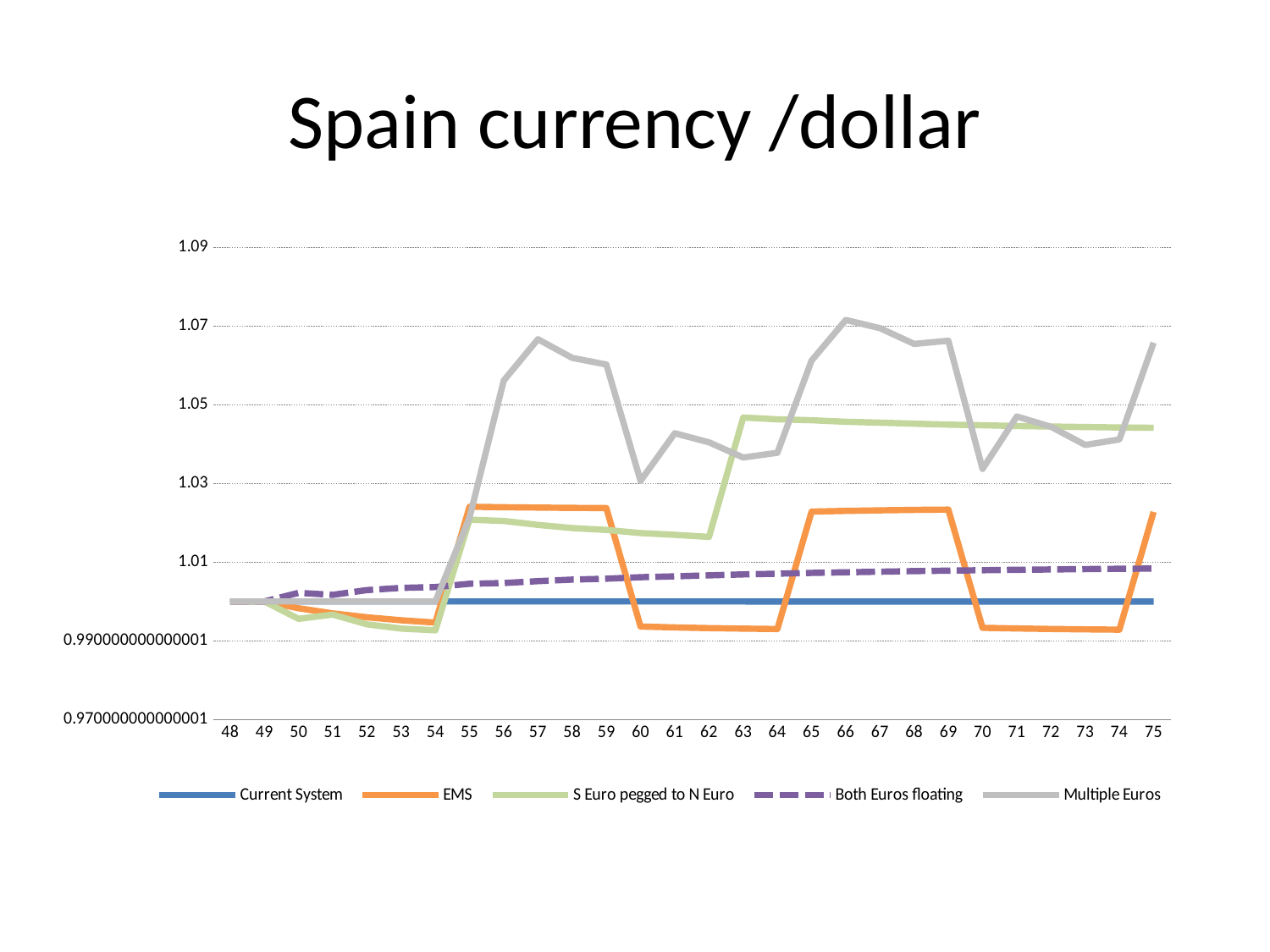
What is the title of the chart? Spain currency /dollar How many series does the legend list? 5 Is the value for EMS at 55 greater or less than 1.03? less Is the value for Multiple Euros at 66 greater or less than 1.05? greater Is the value for Multiple Euros at 60 greater or less than 1.05? less Which series is drawn with a dashed line? Both Euros floating Does the Both Euros floating series generally rise or fall from 48 to 75? rise How many points are on the x axis of the chart? 28 Which series has the highest value at 66? Multiple Euros What kind of chart is shown on the slide? line chart At 63, which is larger: S Euro pegged to N Euro or Multiple Euros? S Euro pegged to N Euro